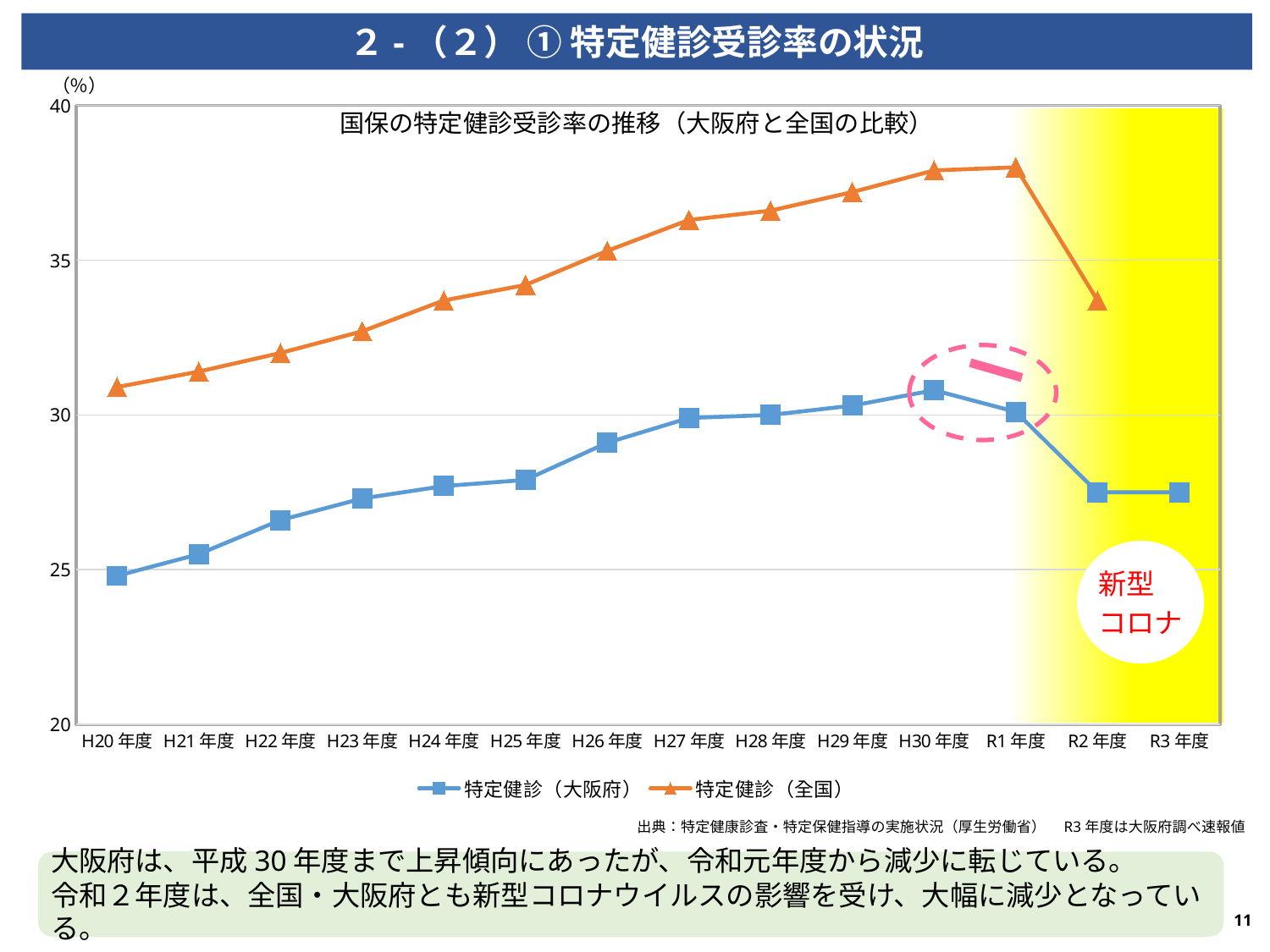
What kind of chart is shown on the slide? line chart What is the title of the chart? 国保の特定健診受診率の推移（大阪府と全国の比較） Is the value for 特定健診（全国） in R2年度 greater or less than 35? less How many fiscal-year categories are shown on the x axis? 14 In which fiscal year is the 特定健診（全国） series at its lowest? H20年度 How many series does the legend list? 2 Is the value for 特定健診（全国） in R1年度 greater or less than 35? greater Is the value for 特定健診（大阪府） in H30年度 greater or less than 30? greater In which fiscal year is the 特定健診（大阪府） series at its highest? H30年度 In H25年度, which series has the higher value, 特定健診（大阪府） or 特定健診（全国）? 特定健診（全国） Which series is drawn with orange triangle markers? 特定健診（全国）